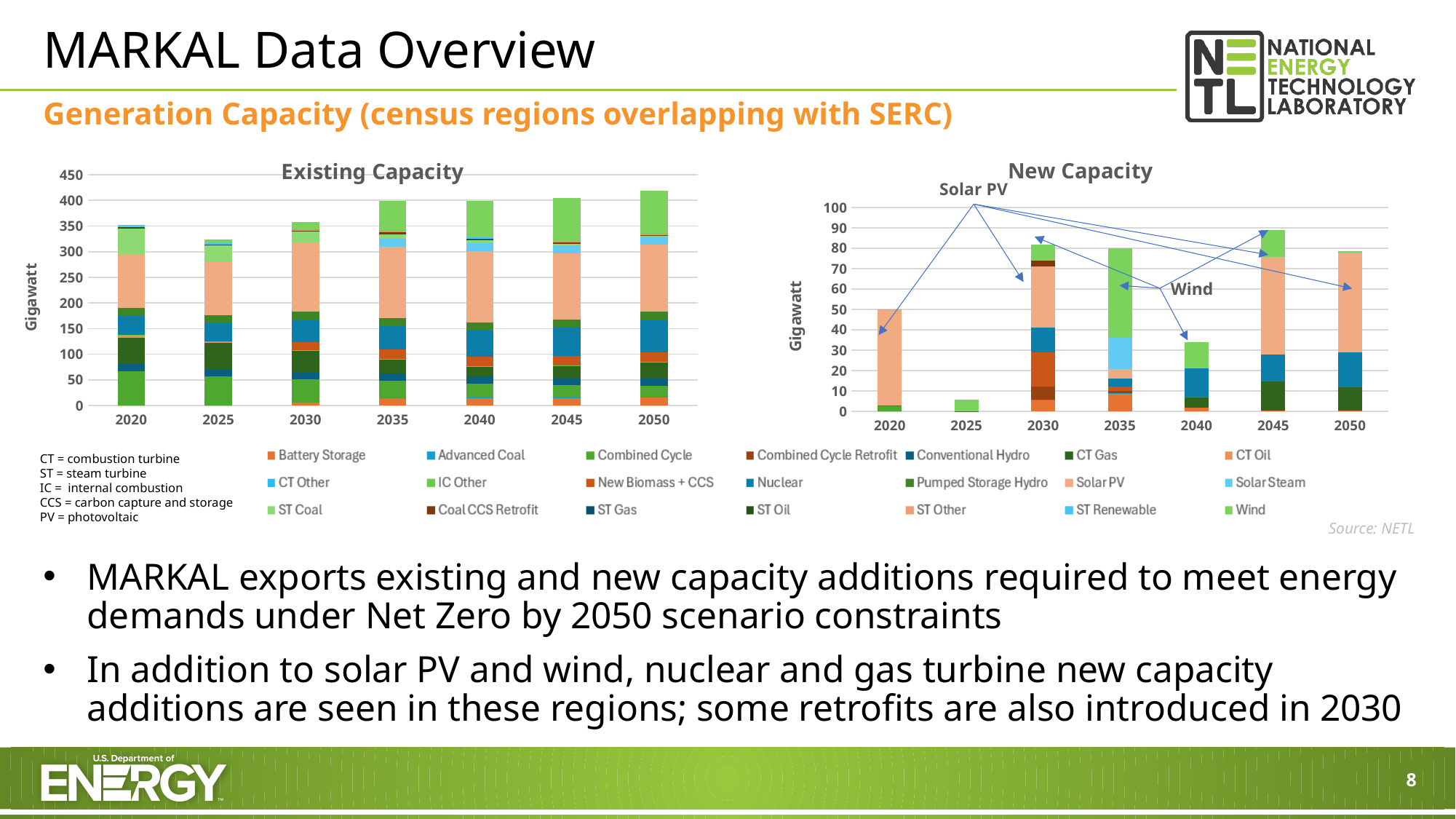
In the New Capacity chart, which bar is taller, 2020 or 2040? 2020 In the Existing Capacity chart, is the total for 2025 greater or less than 350? less In the New Capacity chart, which year has the shortest bar? 2025 How many years are shown on the x axis of the New Capacity chart? 7 In the New Capacity chart, is the total for 2040 greater or less than 40? less How many series does the shared legend list? 21 In the Existing Capacity chart, which year has the shortest bar? 2025 In the Existing Capacity chart, which year has the tallest bar? 2050 In the New Capacity chart, which year has the tallest bar? 2045 What kind of chart is the Existing Capacity chart? Stacked bar chart In the Existing Capacity chart, is the total for 2050 greater or less than 400? greater What unit is shown on the y axis of both charts? Gigawatt